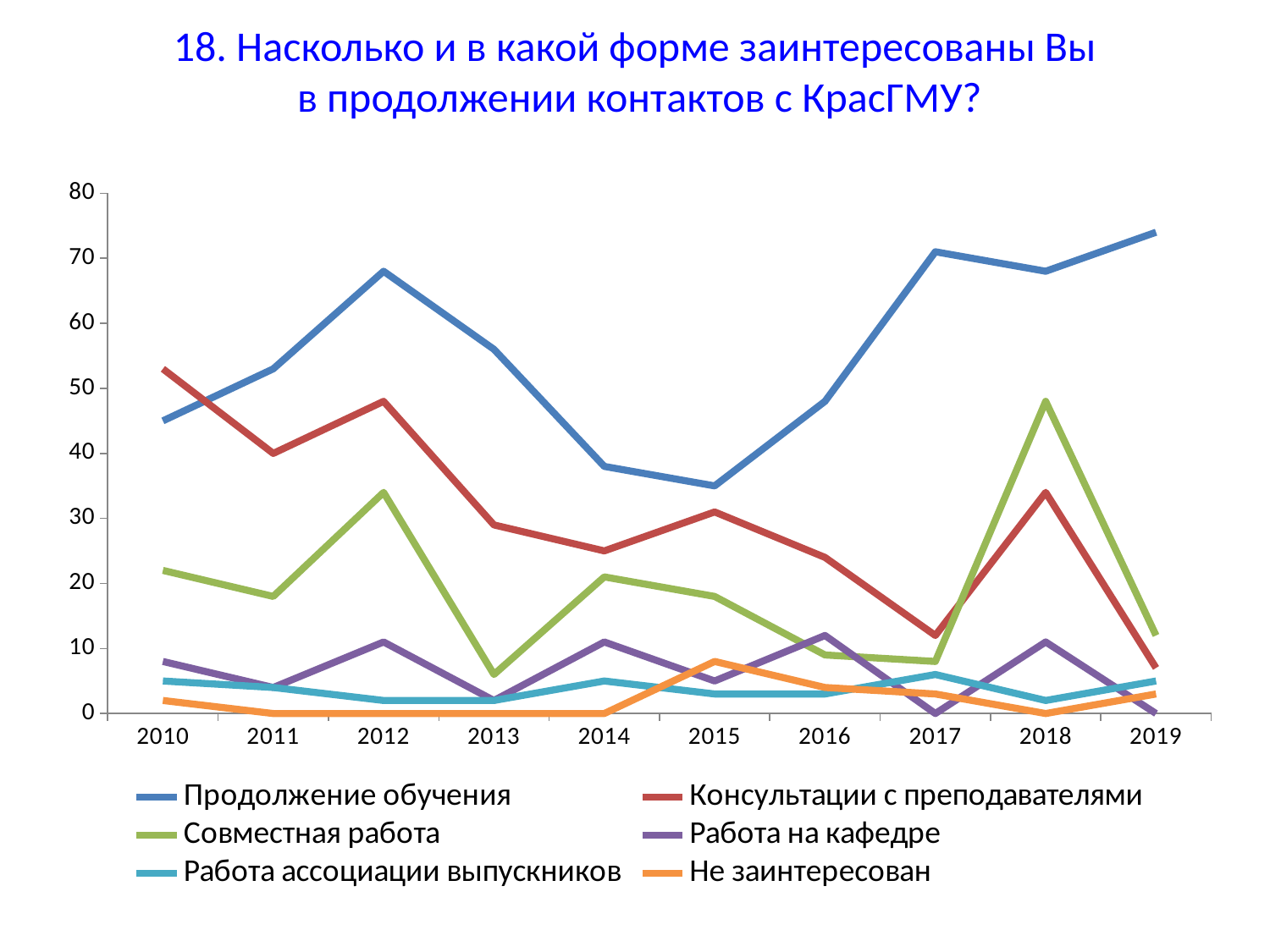
Is the value for 'Продолжение обучения' in 2017 greater or less than 60? greater In which year does the series 'Продолжение обучения' reach its highest value? 2019 How many series does the legend list? 6 Which series has the higher value in 2010: 'Продолжение обучения' or 'Консультации с преподавателями'? Консультации с преподавателями Is the value for 'Консультации с преподавателями' in 2017 greater or less than 20? less What kind of chart is shown on the slide? line chart What is the value for 'Не заинтересован' in 2012? 0 Does the series 'Консультации с преподавателями' rise or fall from 2018 to 2019? fall How many years are shown along the x axis? 10 In which year does the series 'Продолжение обучения' reach its lowest value? 2015 In which year does the series 'Совместная работа' reach its highest value? 2018 Which series is drawn in orange in the legend? Не заинтересован